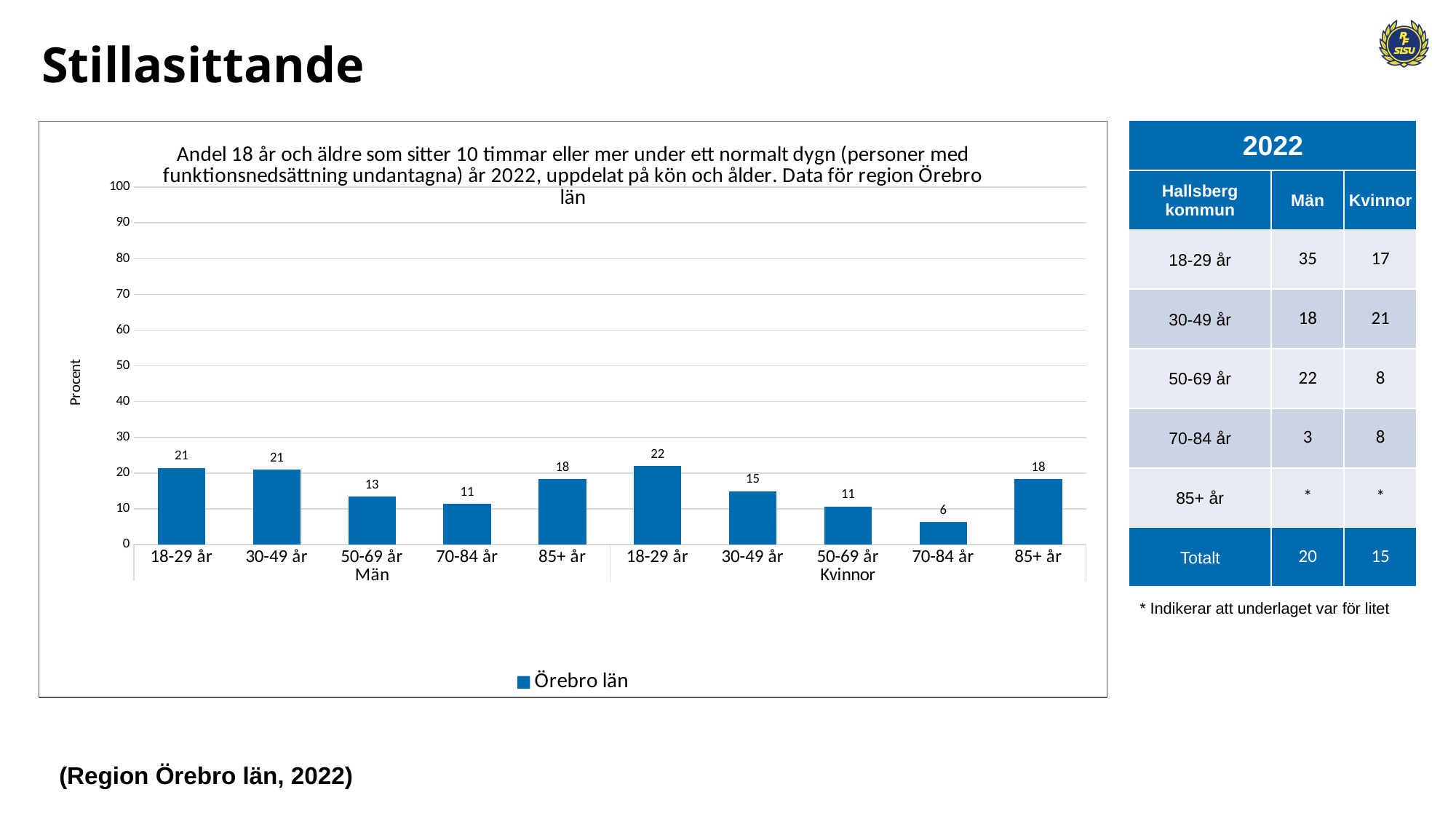
How many bars are plotted in the chart? 10 What is the value for women aged 70-84 år in the chart? 6 Which bar in the chart has the highest value? Kvinnor 18-29 år Is the value for men aged 85+ år greater or less than 30? less What is the value for men aged 18-29 år in the chart? 21 How many series does the chart legend list? 1 What type of chart is shown on the slide? Bar chart What is the value for women aged 30-49 år in the chart? 15 What is the difference between the value for women aged 18-29 år and women aged 70-84 år? 16 Which bar in the chart has the lowest value? Kvinnor 70-84 år Which is larger: the value for men aged 70-84 år or women aged 70-84 år? Men aged 70-84 år What is the value for men aged 50-69 år in the chart? 13